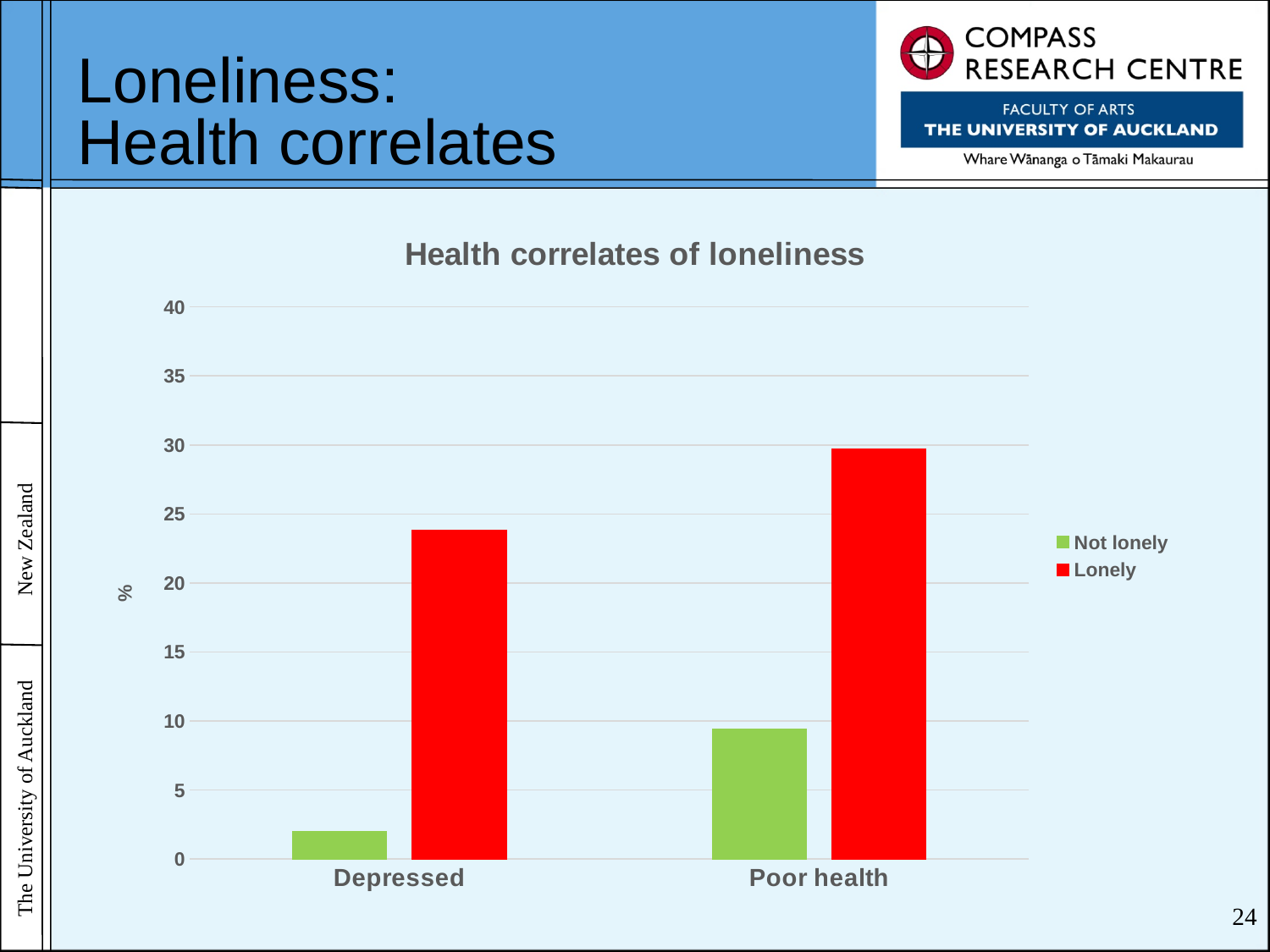
How many categories are shown on the x axis? 2 Is the value for Lonely in the Poor health category greater or less than 25? greater In the Poor health category, which is larger: Lonely or Not lonely? Lonely Which series is shown in red? Lonely How many series does the legend list? 2 Which bar is the shortest in the chart? Not lonely, Depressed Is the value for Not lonely in the Depressed category greater or less than 5? less Which bar is the tallest in the chart? Lonely, Poor health Is the value for Lonely in the Depressed category greater or less than 20? greater What is the title of the chart? Health correlates of loneliness What kind of chart is shown on the slide? bar chart